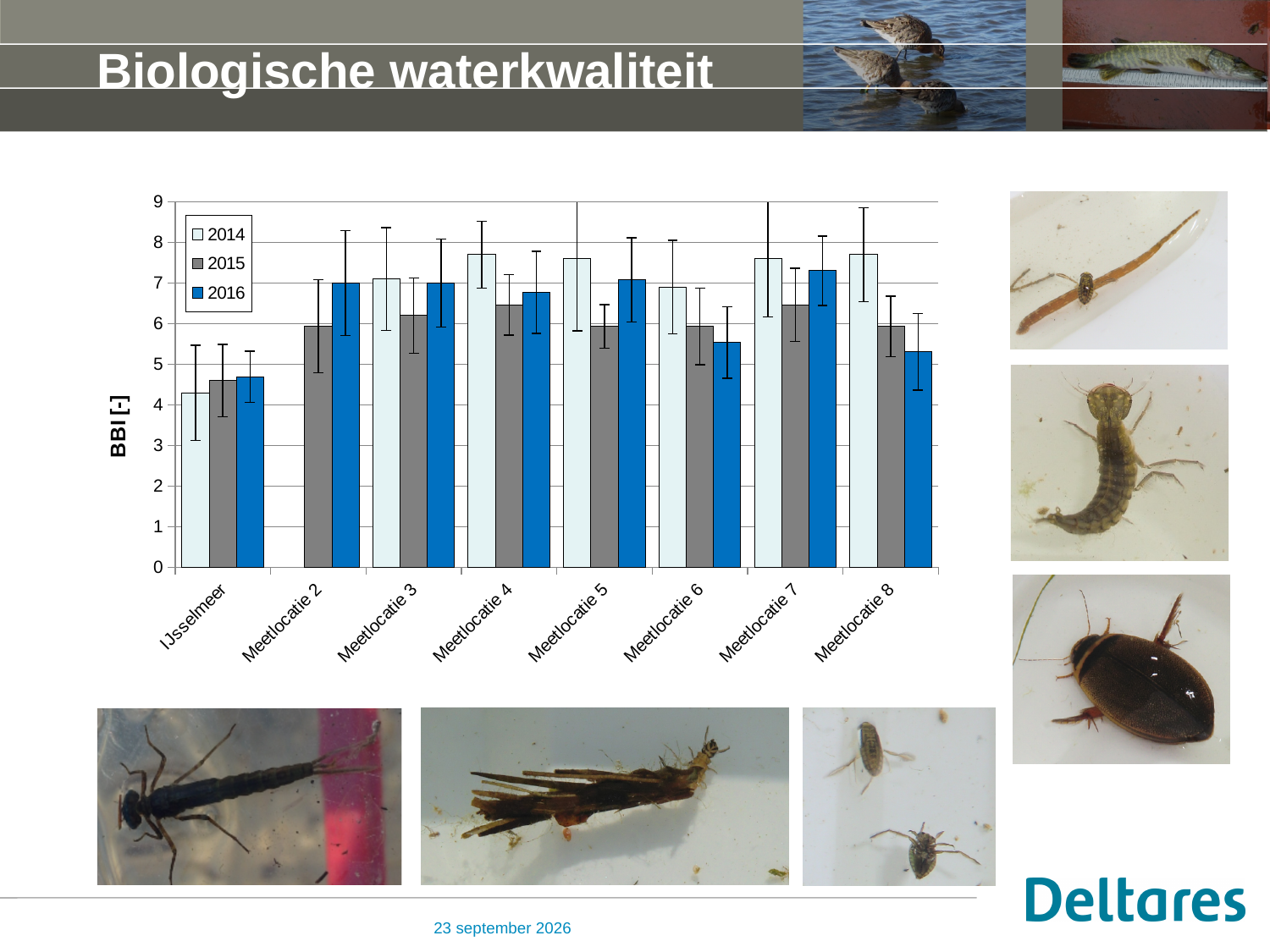
How many series does the legend list? 3 Which years are listed in the chart legend? 2014, 2015, 2016 What is the label of the vertical axis? BBI [-] For Meetlocatie 3, which is larger: the 2014 value or the 2015 value? 2014 Is the 2015 value for Meetlocatie 3 greater or less than 7? less Is the 2014 value for Meetlocatie 4 greater or less than 7? greater Is the 2016 value for Meetlocatie 6 greater or less than 5? greater How many locations (categories) are shown on the x axis? 8 What kind of chart is shown on the slide? bar chart For Meetlocatie 8, which is larger: the 2014 value or the 2016 value? 2014 Which location has the lowest BBI values across all three years? IJsselmeer